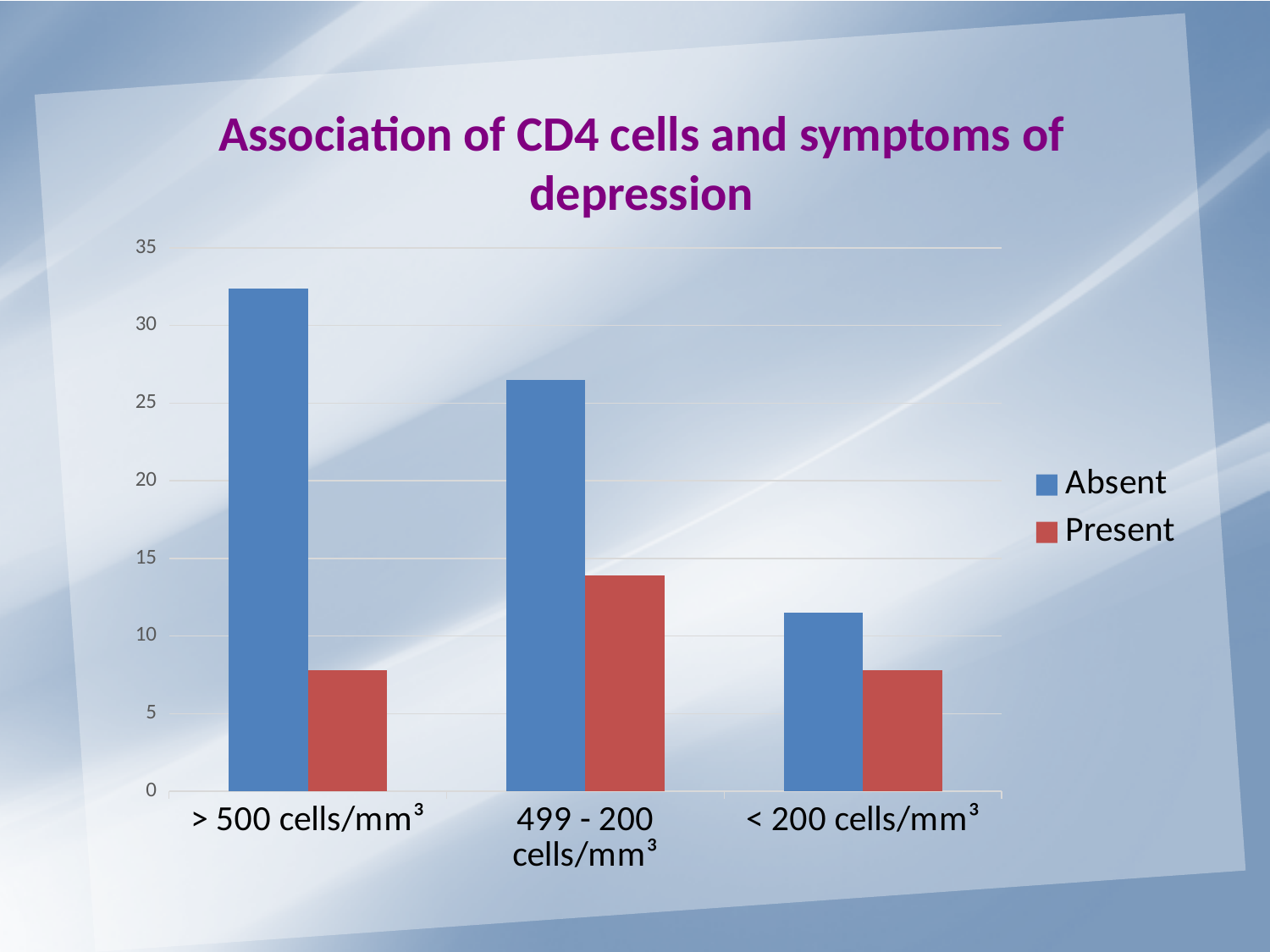
For the 499 - 200 cells/mm³ category, which is larger, the Absent value or the Present value? Absent Which category has the highest Present value? 499 - 200 cells/mm³ What is the title of the chart? Association of CD4 cells and symptoms of depression Is the Absent value for > 500 cells/mm³ greater or less than 30? greater How many CD4 cell categories are shown on the x axis? 3 Which category has the lowest Absent value? < 200 cells/mm³ What are the two series named in the legend? Absent and Present Which category has the highest Absent value? > 500 cells/mm³ Is the Absent value for < 200 cells/mm³ greater or less than 10? greater Is the Present value for 499 - 200 cells/mm³ greater or less than 15? less How many series does the legend list? 2 What kind of chart is shown on the slide? bar chart